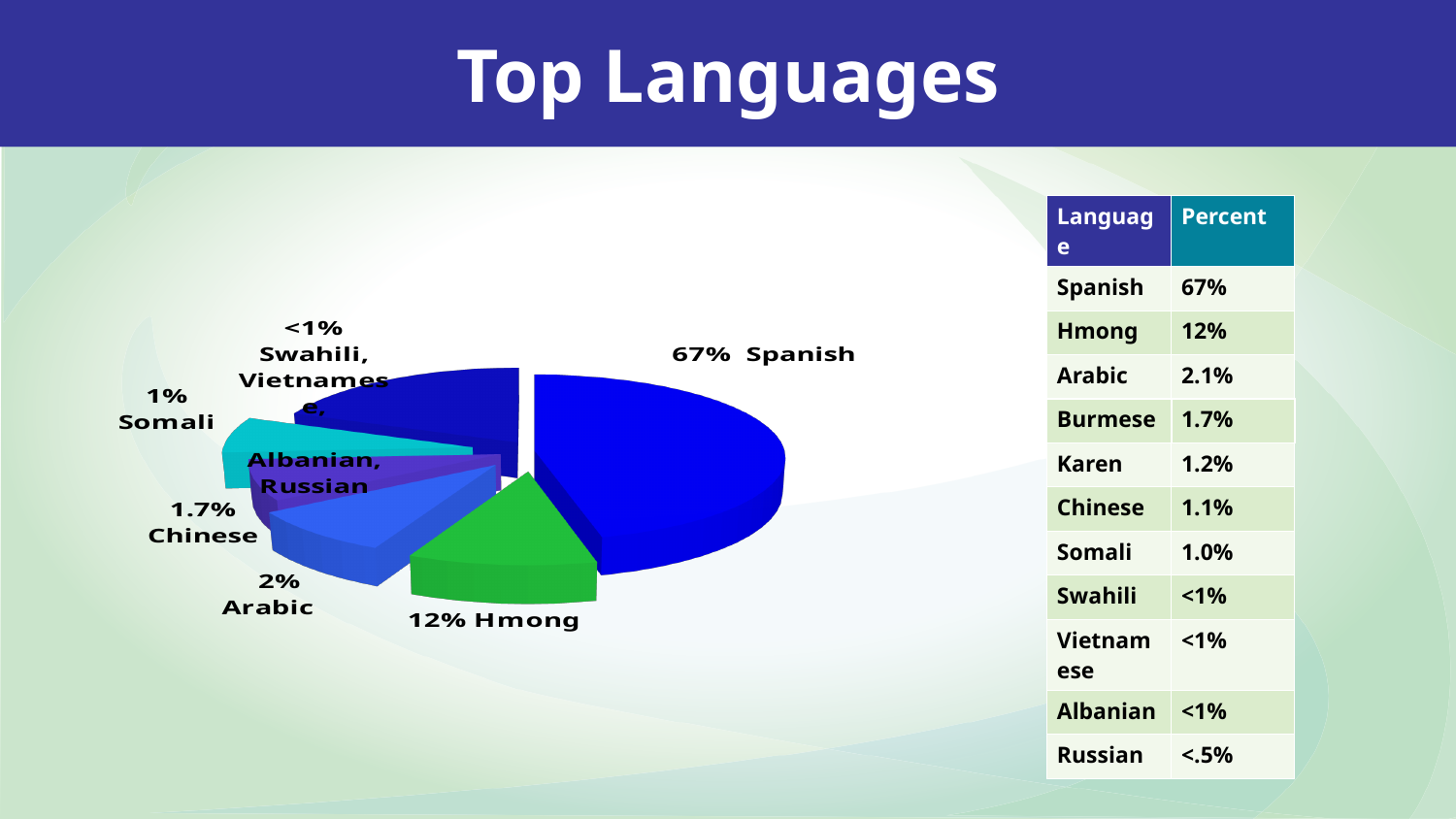
On the pie chart, what percentage is labelled for Hmong? 12% Which language has the largest slice of the pie chart? Spanish On the pie chart, what percentage is labelled for Arabic? 2% On the pie chart, what percentage is labelled for Chinese? 1.7% On the pie chart, which languages are grouped under the '<1%' label? Swahili, Vietnamese On the pie chart, what percentage is labelled for Spanish? 67% On the pie chart, what percentage is labelled for Somali? 1% What type of chart is shown on the slide? pie chart On the pie chart, how many percentage points larger is the Spanish share than the Hmong share? 55 On the pie chart, which is larger, the Hmong slice or the Arabic slice? Hmong What is the title of the slide containing the pie chart? Top Languages What share of the pie does the Spanish slice represent? 67%